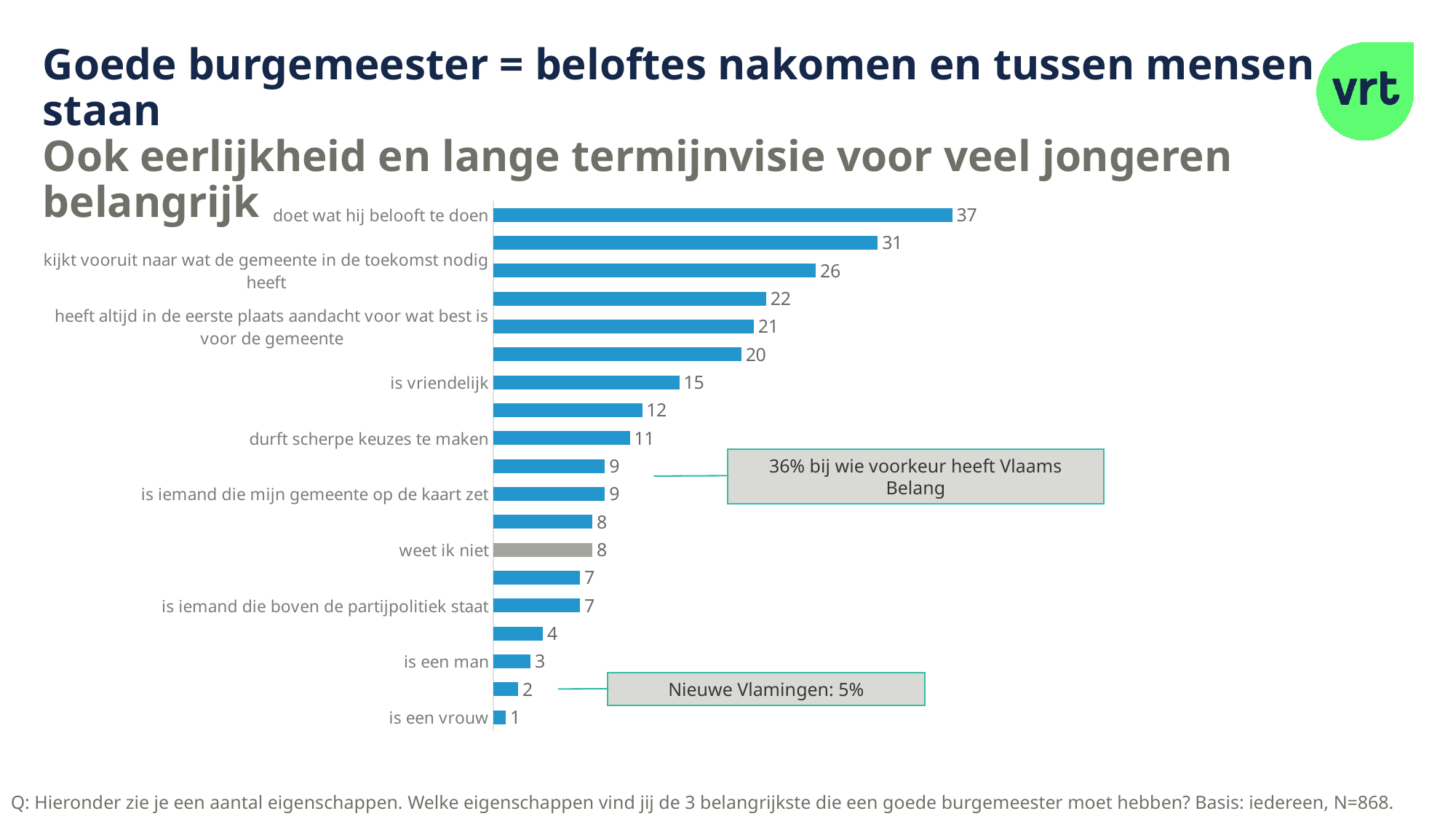
Which is larger: the value for "durft scherpe keuzes te maken" or the value for "is iemand die boven de partijpolitiek staat"? durft scherpe keuzes te maken What is the value for "doet wat hij belooft te doen"? 37 What is the value for "weet ik niet"? 8 What is the difference between the values for "doet wat hij belooft te doen" and "is vriendelijk"? 22 Which category has the lowest value? is een vrouw What is the value for "kijkt vooruit naar wat de gemeente in de toekomst nodig heeft"? 26 How many bars are plotted in the chart? 19 Which category has the highest value? doet wat hij belooft te doen What kind of chart is shown on the slide? bar chart Which category's bar is coloured grey instead of blue? weet ik niet What is the value for "is een man"? 3 What is the value for "is vriendelijk"? 15